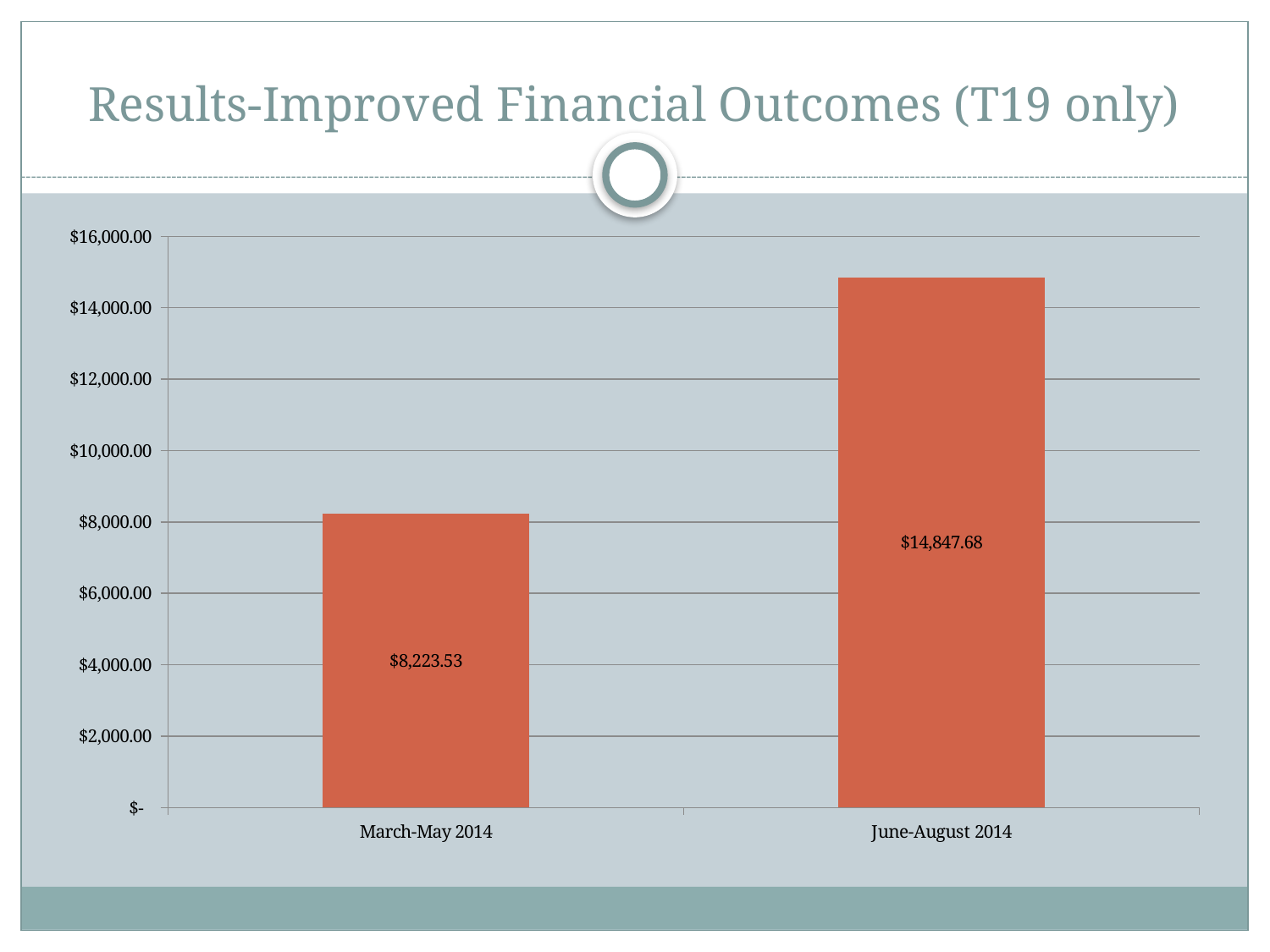
What is the title of the slide? Results-Improved Financial Outcomes (T19 only) Do the values rise or fall from March-May 2014 to June-August 2014? rise Which period has the highest value? June-August 2014 Which period has the lowest value? March-May 2014 Is the value for June-August 2014 greater or less than $14,000.00? greater What kind of chart is shown on the slide? bar chart How many categories are shown on the x axis? 2 What is the difference between the June-August 2014 value and the March-May 2014 value? $6,624.15 What is the value for June-August 2014? $14,847.68 Which is larger, the value for March-May 2014 or the value for June-August 2014? June-August 2014 What is the value for March-May 2014? $8,223.53 Is the value for March-May 2014 greater or less than $10,000.00? less